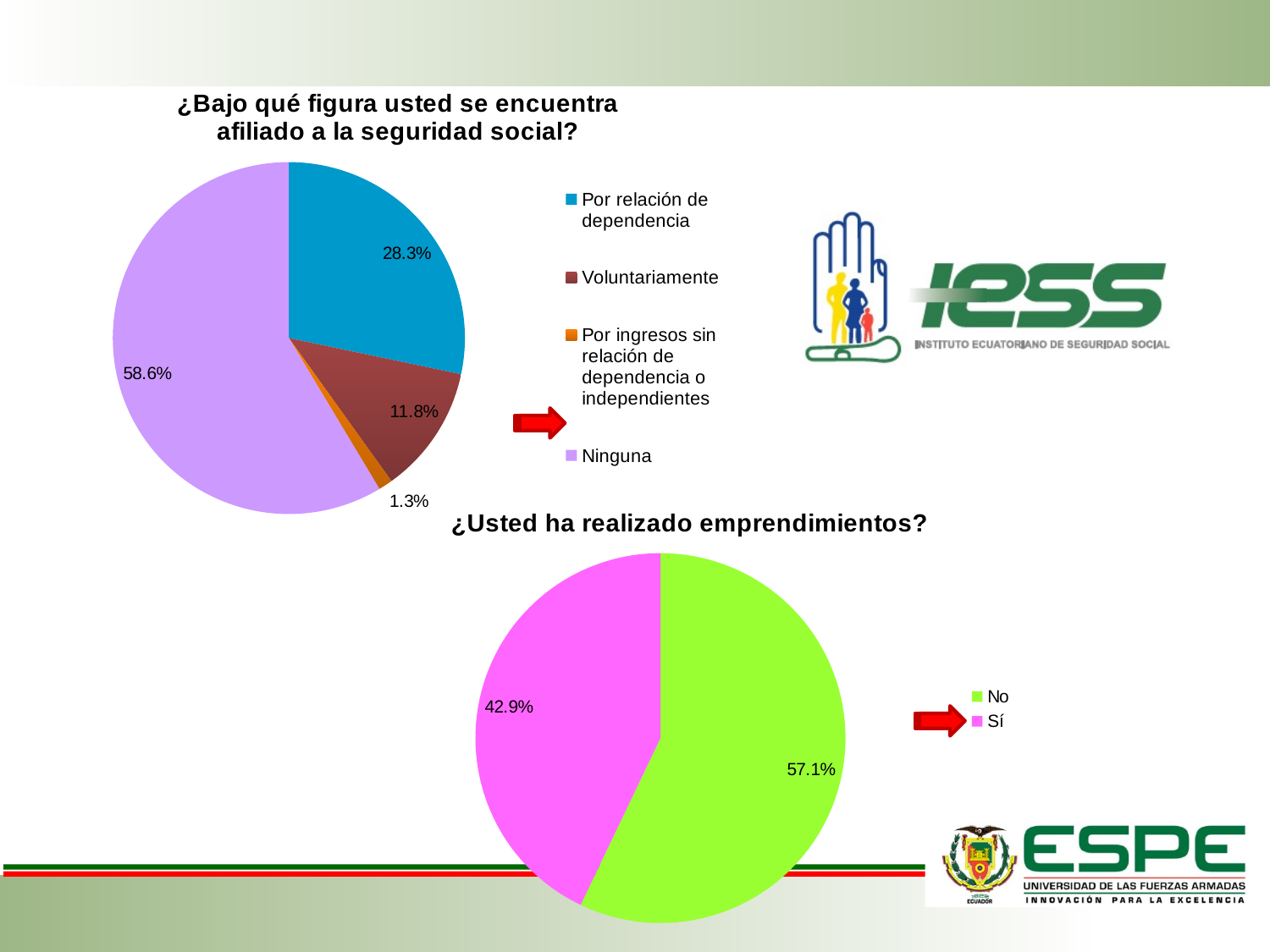
In the chart titled '¿Bajo qué figura usted se encuentra afiliado a la seguridad social?', which category has the largest slice? Ninguna In the chart titled '¿Usted ha realizado emprendimientos?', what colour is the 'Sí' slice? Pink In the chart titled '¿Usted ha realizado emprendimientos?', which is larger, 'No' or 'Sí'? No In the chart titled '¿Bajo qué figura usted se encuentra afiliado a la seguridad social?', what share is labelled for 'Voluntariamente'? 11.8% What kind of chart is used for '¿Usted ha realizado emprendimientos?'? Pie chart In the chart titled '¿Bajo qué figura usted se encuentra afiliado a la seguridad social?', which category has the smallest slice? Por ingresos sin relación de dependencia o independientes In the chart titled '¿Usted ha realizado emprendimientos?', what share is labelled for 'No'? 57.1% In the chart titled '¿Bajo qué figura usted se encuentra afiliado a la seguridad social?', what is the difference in percentage points between 'Ninguna' and 'Por relación de dependencia'? 30.3 In the chart titled '¿Bajo qué figura usted se encuentra afiliado a la seguridad social?', what share is labelled for 'Ninguna'? 58.6% In the chart titled '¿Usted ha realizado emprendimientos?', what share is labelled for 'Sí'? 42.9% In the chart titled '¿Bajo qué figura usted se encuentra afiliado a la seguridad social?', how many categories does the legend list? 4 In the chart titled '¿Bajo qué figura usted se encuentra afiliado a la seguridad social?', what share is labelled for 'Por relación de dependencia'? 28.3%